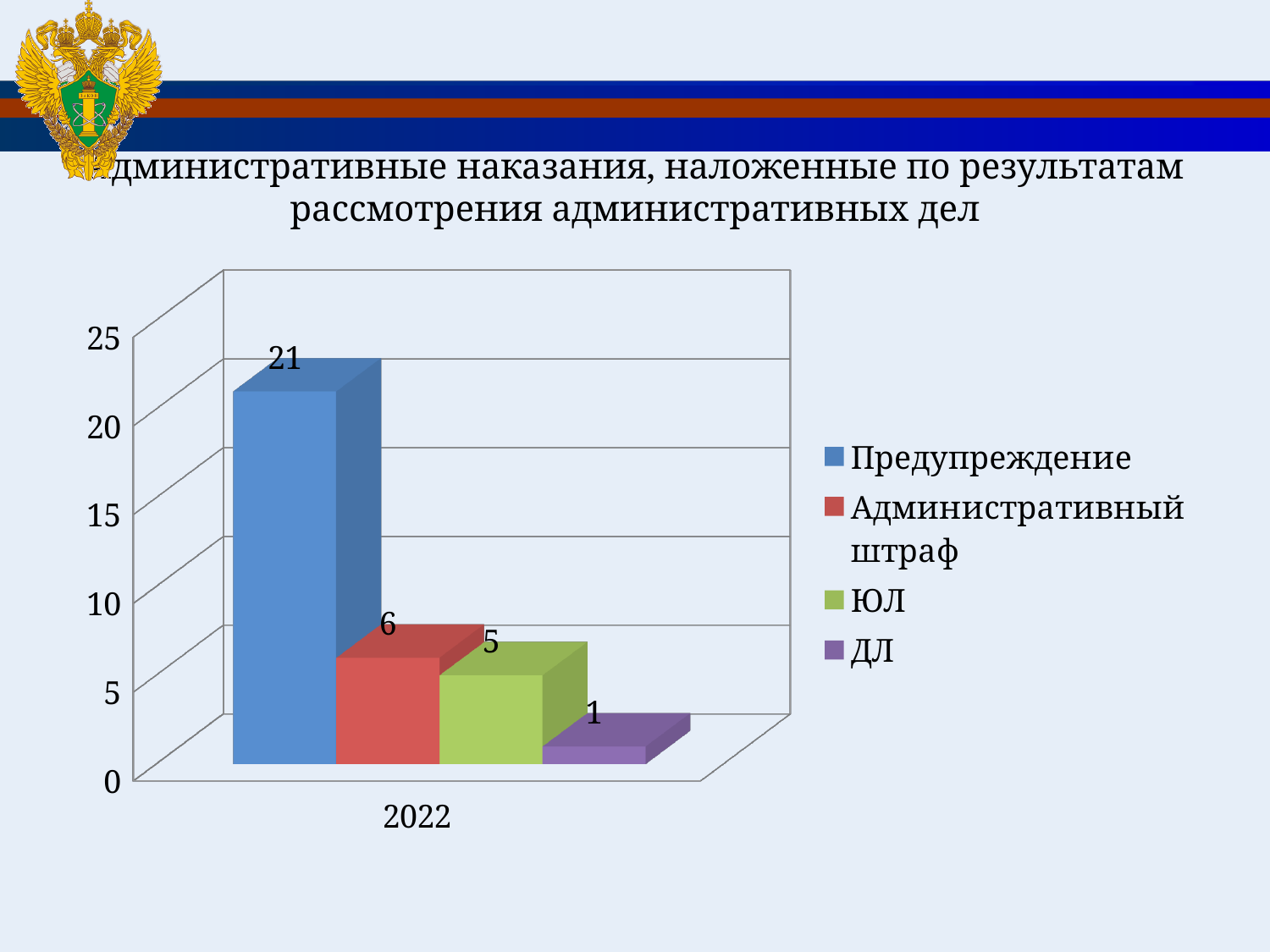
What kind of chart is shown on the slide? bar chart Is the value for Предупреждение greater or less than 20? greater Which year is shown on the x axis of the chart? 2022 Which series has the lowest value in 2022? ДЛ What is the value for ДЛ in 2022? 1 What is the value for ЮЛ in 2022? 5 What is the value for Административный штраф in 2022? 6 How many series does the legend list? 4 Which is larger, the value for ЮЛ or the value for ДЛ? ЮЛ What is the value for Предупреждение in 2022? 21 Which series has the highest value in 2022? Предупреждение What is the difference between the values for Предупреждение and Административный штраф? 15